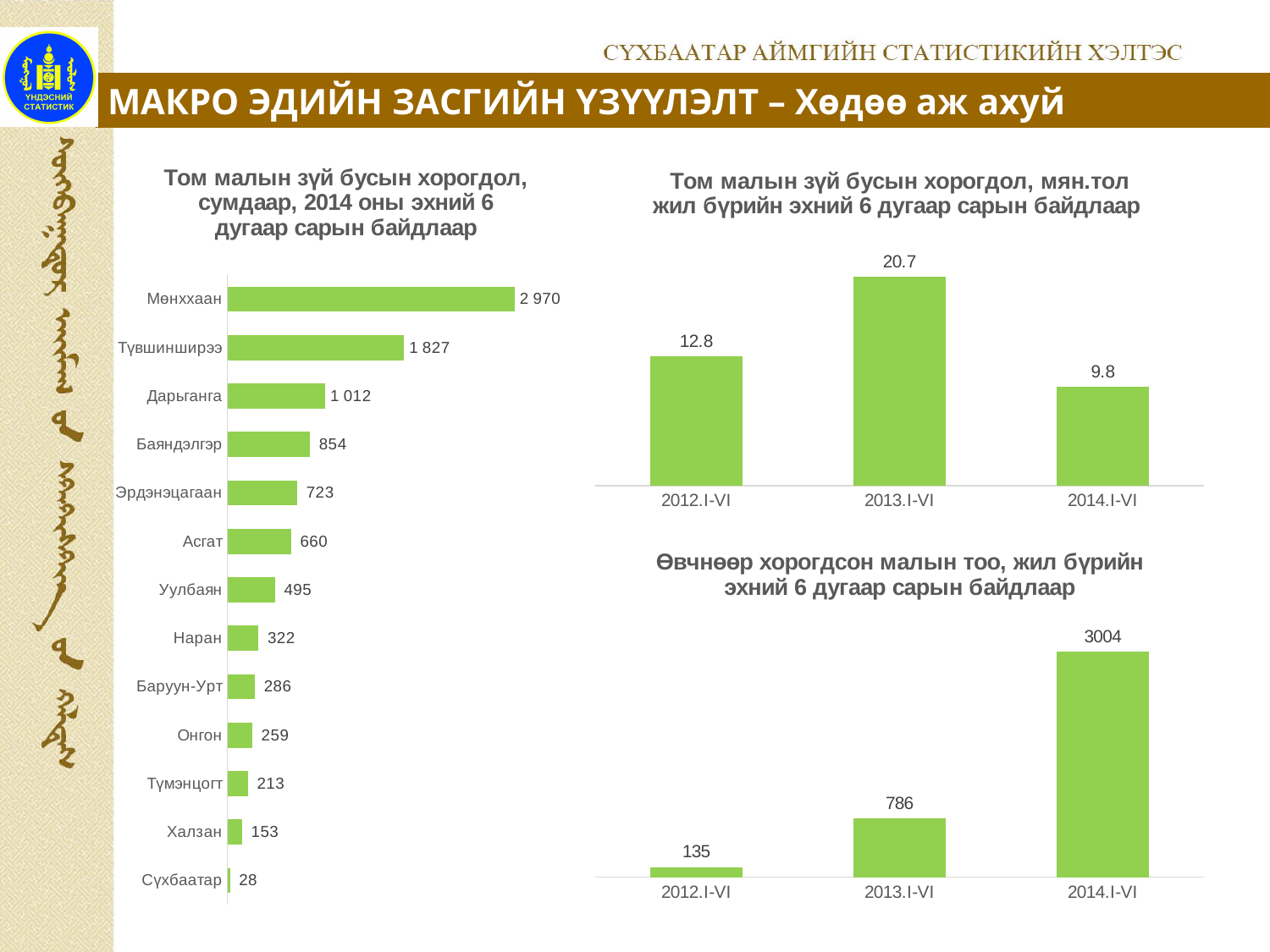
In the left chart (Том малын зүй бусын хорогдол, сумдаар), what is the value for Мөнххаан? 2 970 In the left chart (Том малын зүй бусын хорогдол, сумдаар), what is the value for Халзан? 153 In the top-right chart (Том малын зүй бусын хорогдол, мян.тол), what is the difference between 2012.I-VI and 2014.I-VI? 3.0 In the top-right chart (Том малын зүй бусын хорогдол, мян.тол), which period has the highest value? 2013.I-VI What type of chart is the left chart (Том малын зүй бусын хорогдол, сумдаар)? bar chart In the left chart (Том малын зүй бусын хорогдол, сумдаар), which is larger, Асгат or Уулбаян? Асгат In the top-right chart (Том малын зүй бусын хорогдол, мян.тол), what is the value for 2013.I-VI? 20.7 In the left chart (Том малын зүй бусын хорогдол, сумдаар), what is the difference between Түвшинширээ and Дарьганга? 815 In the left chart (Том малын зүй бусын хорогдол, сумдаар), which category has the lowest value? Сүхбаатар In the left chart (Том малын зүй бусын хорогдол, сумдаар), how many categories are shown? 13 In the bottom-right chart (Өвчнөөр хорогдсон малын тоо), what is the value for 2014.I-VI? 3004 In the bottom-right chart (Өвчнөөр хорогдсон малын тоо), do the values rise or fall from 2012.I-VI to 2014.I-VI? rise